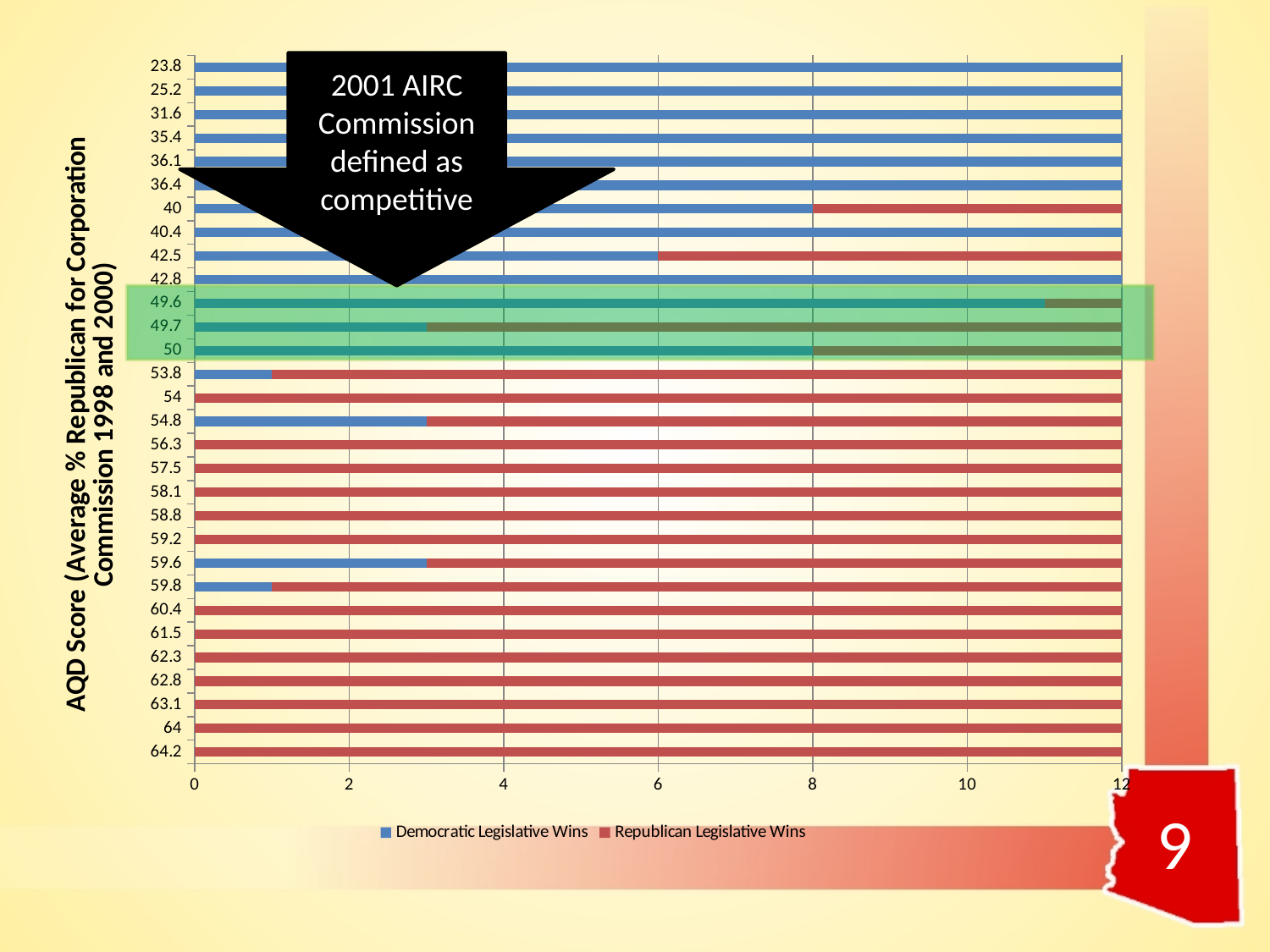
What are the two series named in the legend? Democratic Legislative Wins and Republican Legislative Wins Is the value of Democratic Legislative Wins for the AQD score of 53.8 greater or less than 2? less What is the value of Democratic Legislative Wins for the AQD score of 23.8? 12 Is the value of Democratic Legislative Wins for the AQD score of 49.6 greater or less than 10? greater For the AQD score of 40, which is larger: Democratic Legislative Wins or Republican Legislative Wins? Democratic Legislative Wins How many series does the legend list? 2 How many AQD score categories are plotted on the chart? 30 What kind of chart is shown on the slide? Stacked bar chart What is the total of the stacked bar for the AQD score of 40? 12 What is the value of Republican Legislative Wins for the AQD score of 64.2? 12 What is the value of Democratic Legislative Wins for the AQD score of 40? 8 What is the value of Democratic Legislative Wins for the AQD score of 42.5? 6